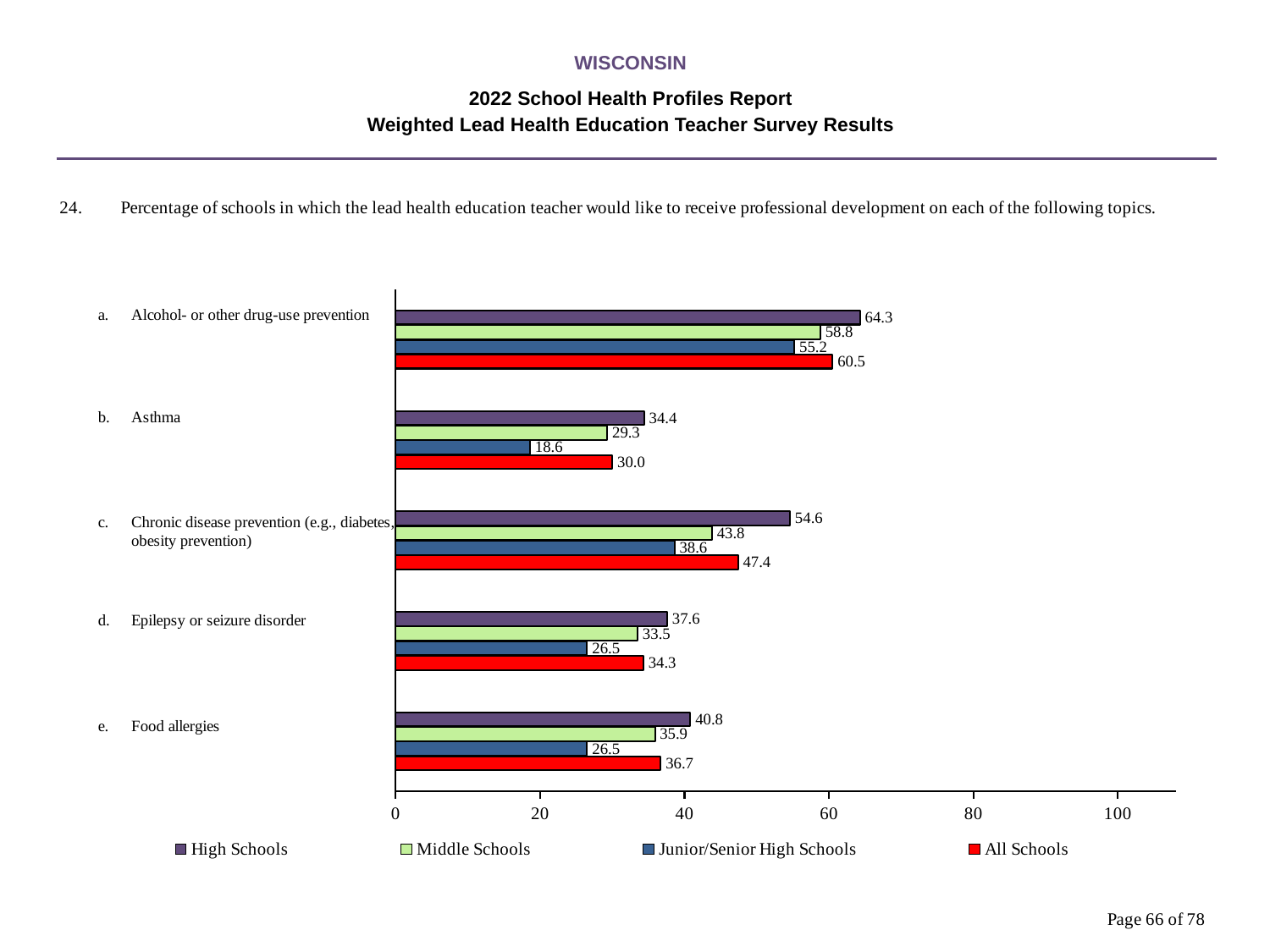
What is the value for High Schools for Alcohol- or other drug-use prevention? 64.3 How many topics are shown on the chart? 5 What kind of chart is shown on the slide? bar chart Which topic has the lowest value for High Schools? Asthma Which is larger for Epilepsy or seizure disorder: the Middle Schools value or the Junior/Senior High Schools value? Middle Schools What is the value for All Schools for Chronic disease prevention (e.g., diabetes, obesity prevention)? 47.4 How many series does the legend list? 4 Which topic has the highest value for All Schools? Alcohol- or other drug-use prevention What is the value for Middle Schools for Food allergies? 35.9 What is the value for Junior/Senior High Schools for Asthma? 18.6 Is the All Schools value for Food allergies greater or less than 40? less What is the difference between the High Schools and Middle Schools values for Chronic disease prevention (e.g., diabetes, obesity prevention)? 10.8